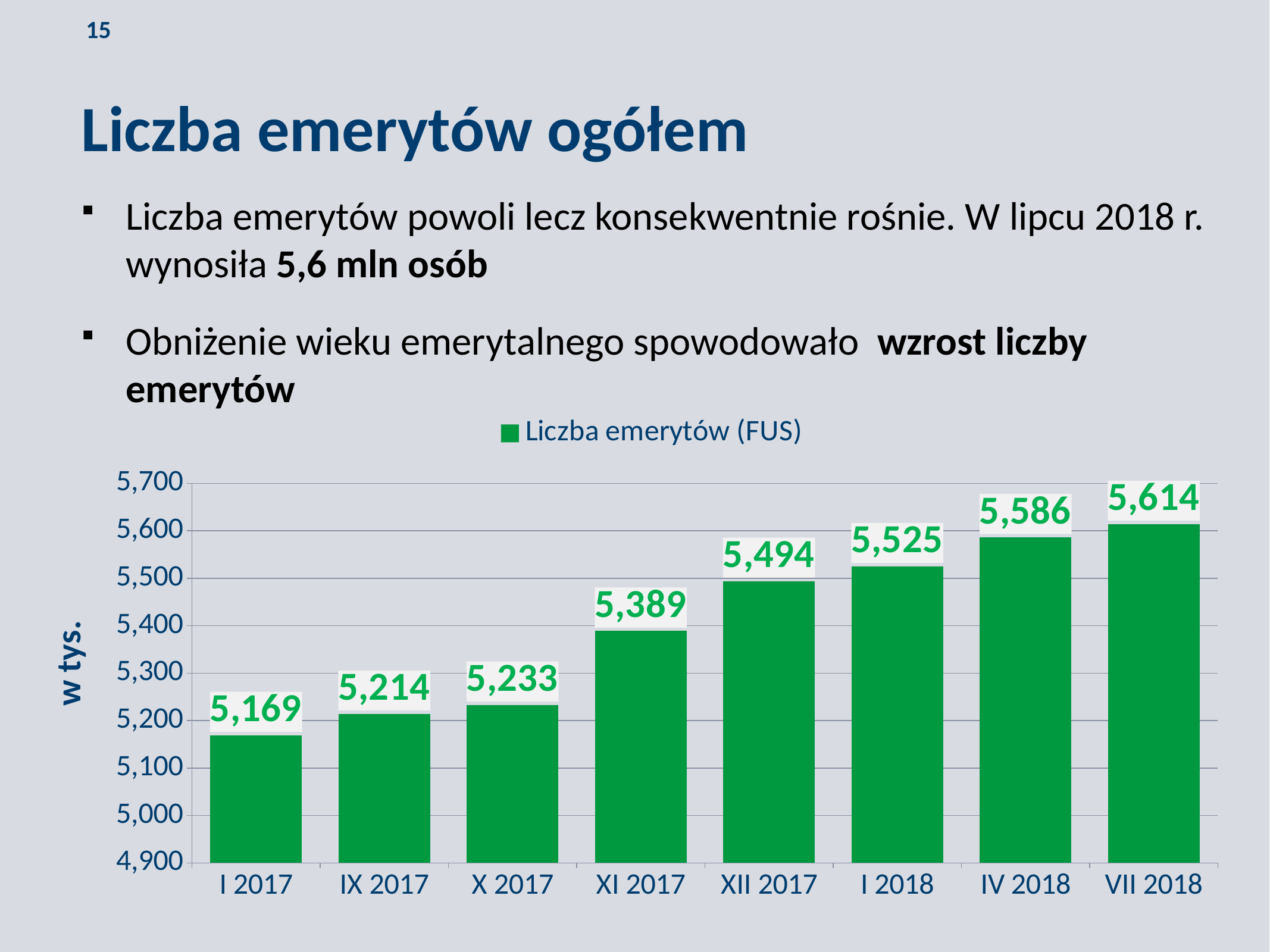
Do the values rise or fall from I 2017 to VII 2018? rise What is the value for XI 2017? 5,389 Is the value for XII 2017 greater or less than 5,400? greater Which period has the lowest value? I 2017 What is the value for IV 2018? 5,586 What is the difference between the values for XII 2017 and XI 2017? 105 Which is larger, the value for X 2017 or the value for I 2018? I 2018 What is the value for I 2017? 5,169 How many periods are shown on the x axis? 8 What is the difference between the values for VII 2018 and I 2017? 445 What kind of chart is shown on the slide? bar chart Which period has the highest value? VII 2018